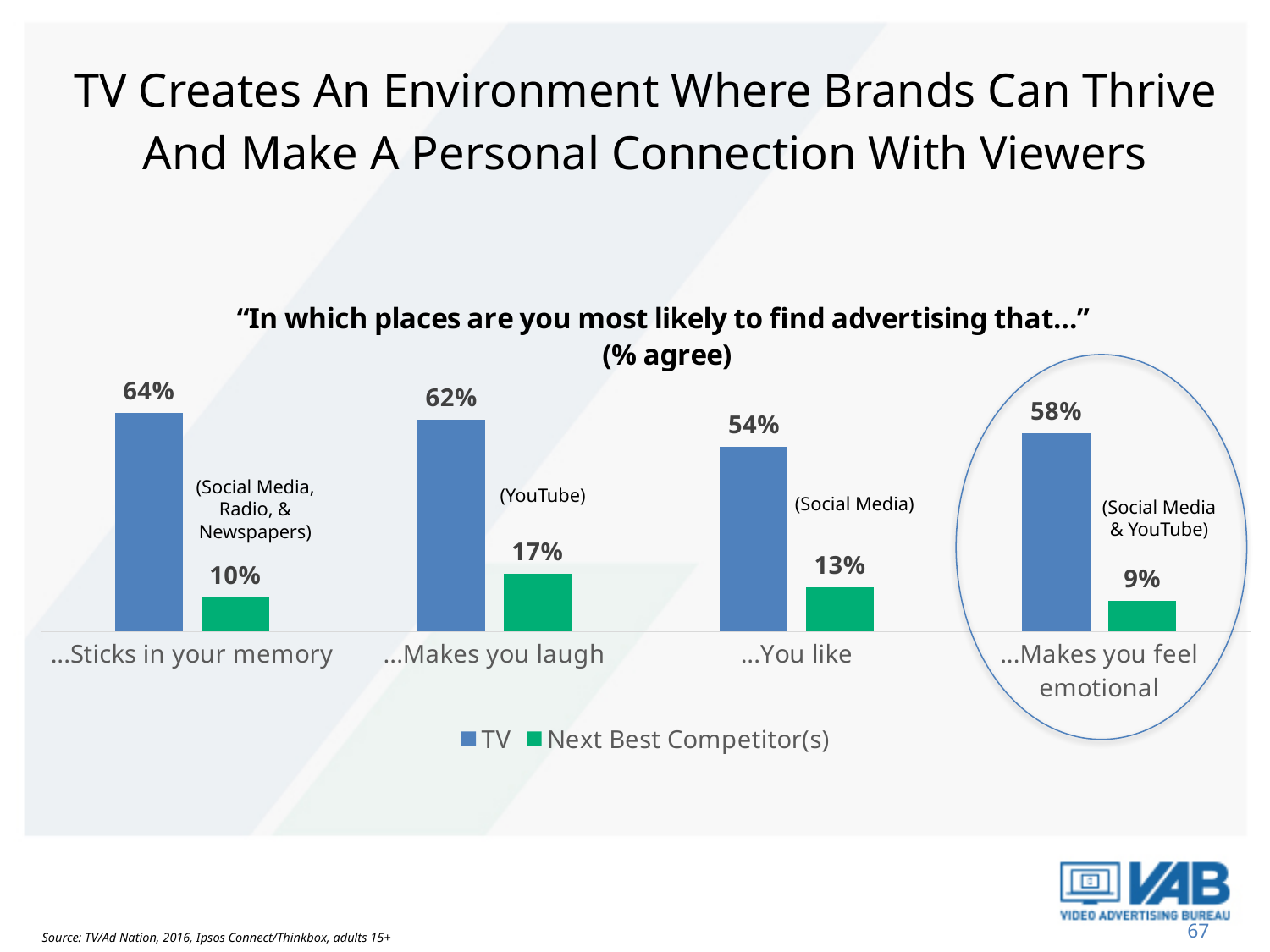
What is the difference between the TV and Next Best Competitor(s) values for "...You like"? 41% Which category on the chart is circled? ...Makes you feel emotional Which category has the lowest Next Best Competitor(s) value? ...Makes you feel emotional What kind of chart is shown on the slide? Bar chart Which is larger: the TV value for "...Makes you laugh" or the TV value for "...You like"? ...Makes you laugh Which competitor is named in parentheses for the "...Makes you laugh" category? YouTube What is the TV value for "...Makes you feel emotional"? 58% What is the value for Next Best Competitor(s) in the "...Makes you laugh" category? 17% What percentage of respondents say TV advertising sticks in your memory? 64% How many categories are shown on the x axis? 4 How many series does the legend list? 2 Which category has the highest TV value? ...Sticks in your memory